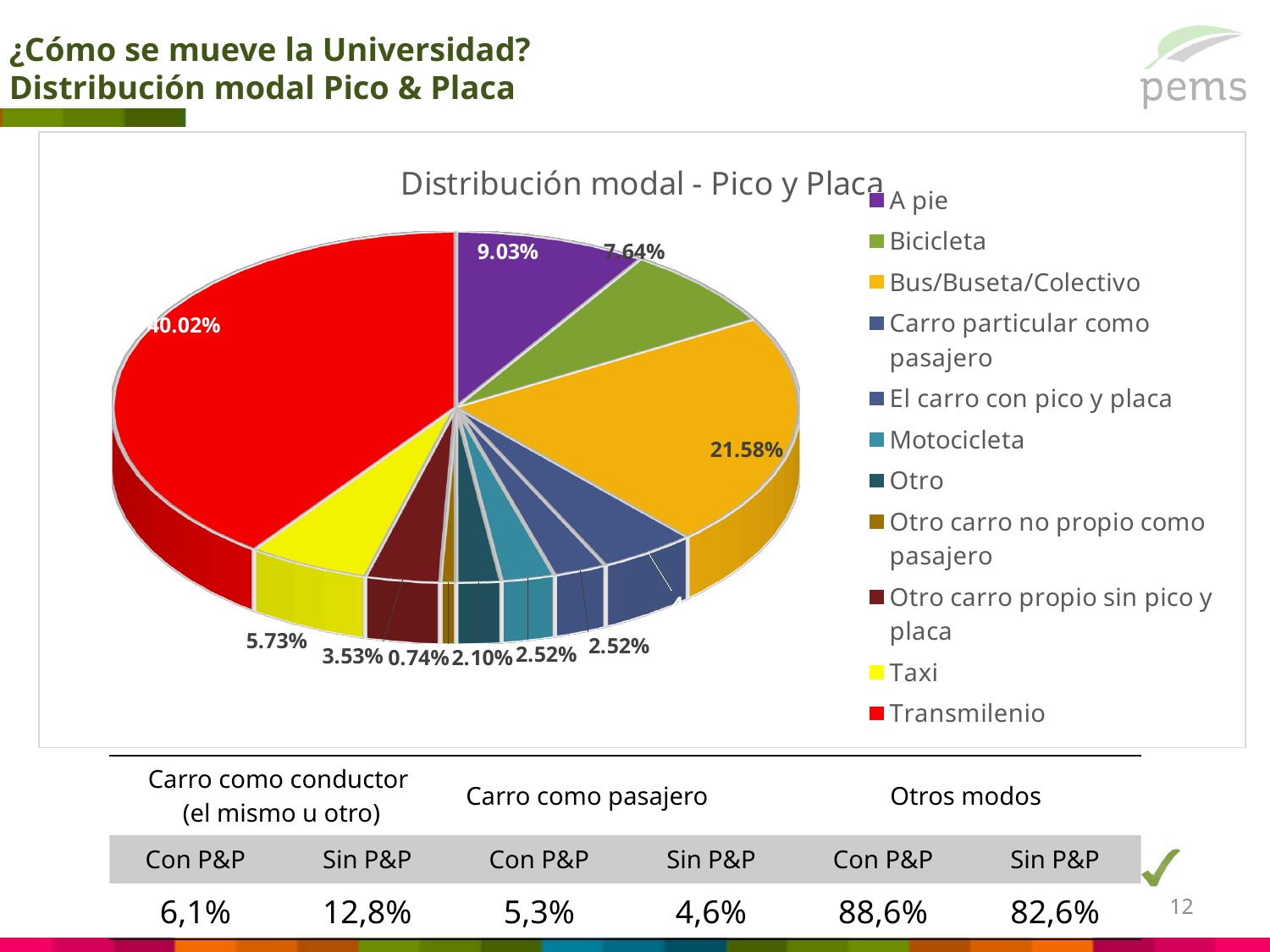
What is the title of the chart? Distribución modal - Pico y Placa What kind of chart is shown on the slide? Pie chart What is the value shown for Taxi? 5.73% Which category has the largest share of the pie? Transmilenio Which has a larger share, A pie or Bicicleta? A pie What is the difference between the Transmilenio share and the Bus/Buseta/Colectivo share? 18.44% What colour is the Transmilenio slice in the pie chart? Red What is the value shown for Bus/Buseta/Colectivo? 21.58% Which category has the smallest share of the pie? Otro carro no propio como pasajero What is the value shown for A pie? 9.03% How many categories does the legend of the pie chart list? 11 What share of the pie does Transmilenio have? 40.02%